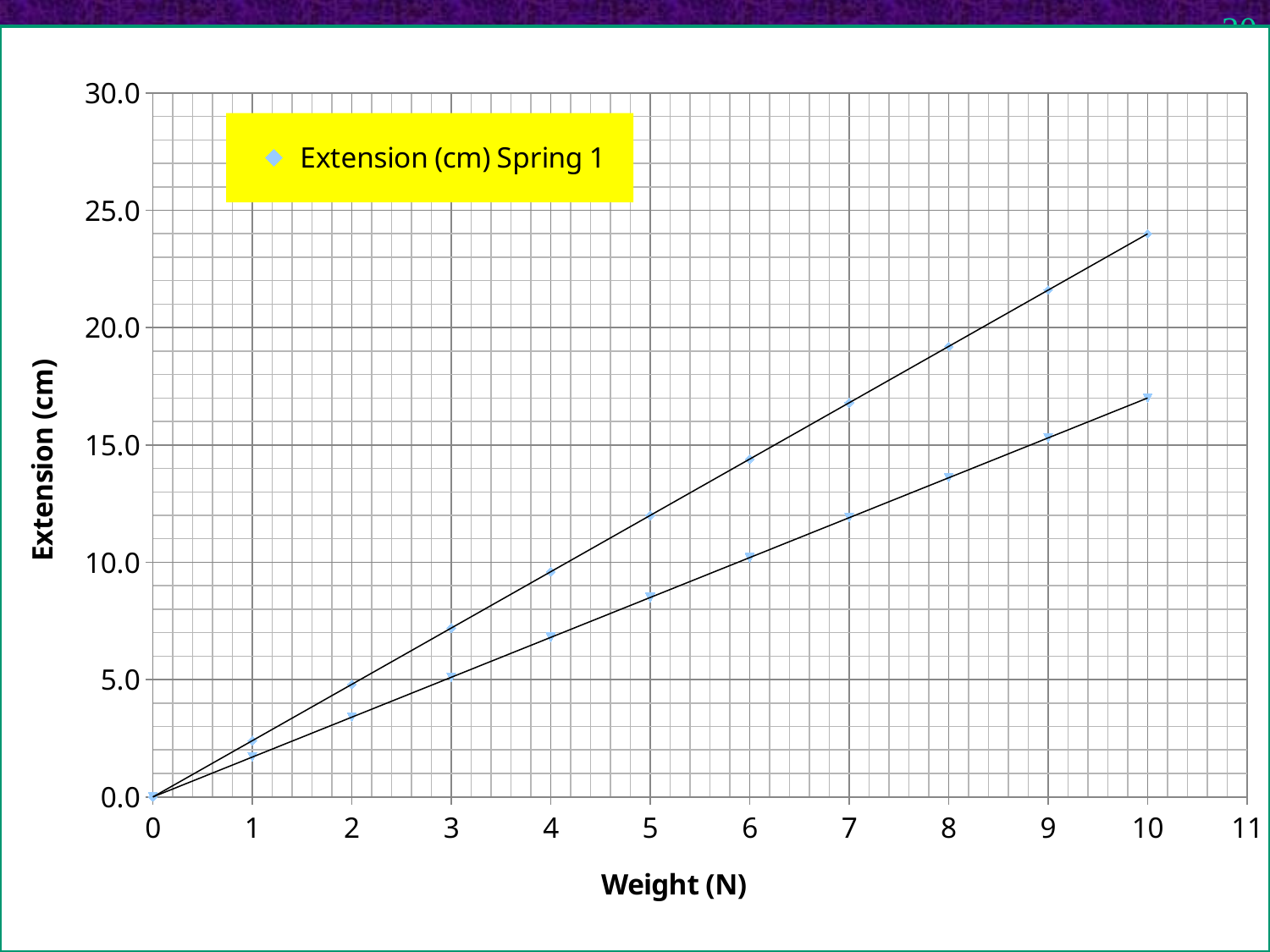
How many data points are plotted on each line (from 0 N to 10 N)? 11 What is the extension at a weight of 0 N? 0.0 What is the title of the y axis? Extension (cm) How many series does the legend list? 1 At a weight of 10 N, which line shows the larger extension, the upper line or the lower line? upper line What kind of chart is shown on the slide? line chart Do the extension values rise or fall as weight increases along the x axis? rise Is the extension of the upper line at 10 N greater or less than 20.0? greater What is the title of the x axis? Weight (N) Is the extension of the lower line at 10 N greater or less than 20.0? less Is the extension of the lower line at 5 N greater or less than 10.0? less At which weight does the upper line reach its highest extension? 10